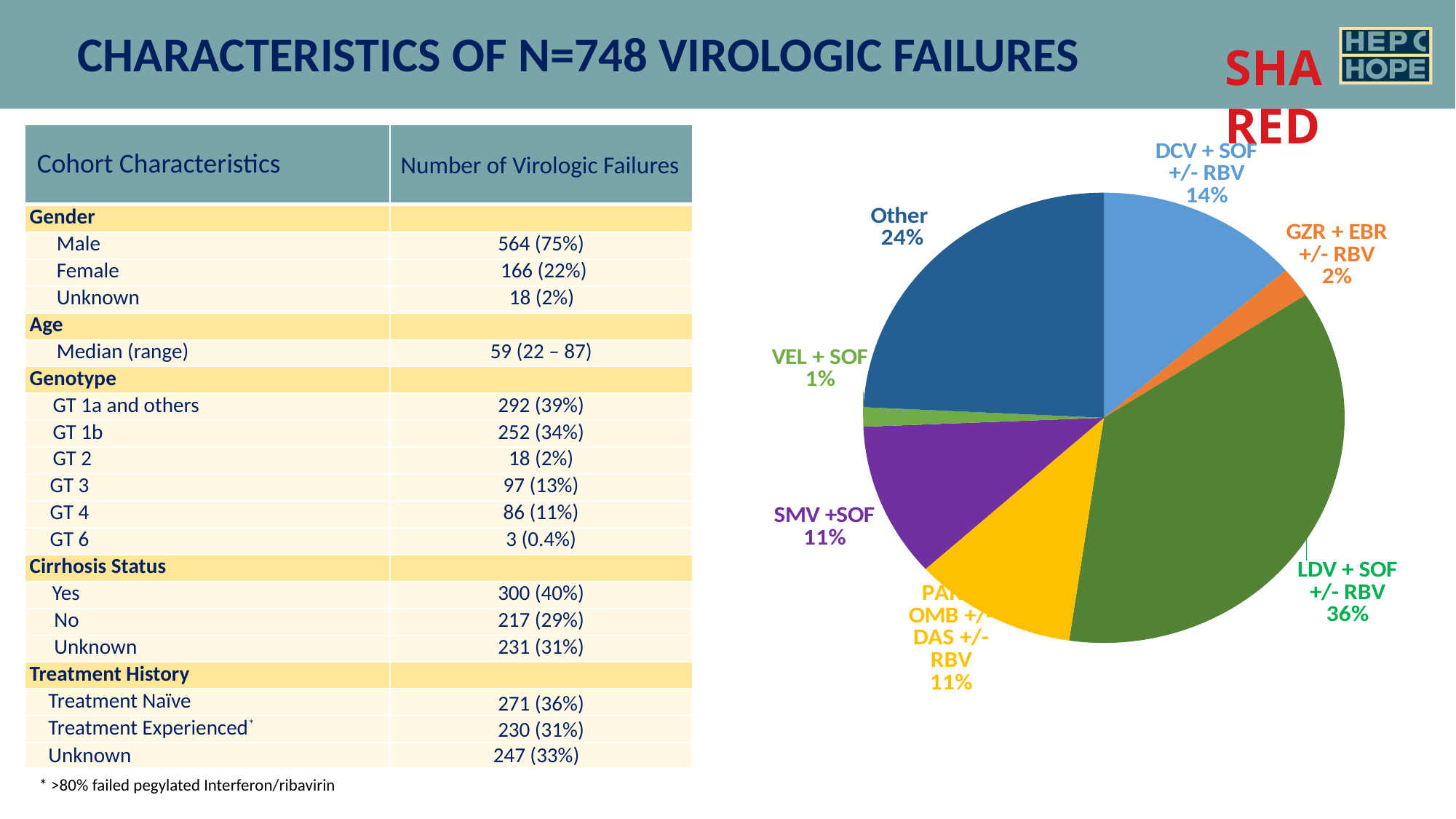
In the pie chart, what percentage is shown for DCV + SOF +/- RBV? 14% Which regimen has the largest slice in the pie chart? LDV + SOF +/- RBV In the pie chart, what percentage is shown for GZR + EBR +/- RBV? 2% In the pie chart, what percentage is shown for the Other category? 24% Which regimen has the smallest slice in the pie chart? VEL + SOF In the pie chart, what is the difference in percentage points between Other and DCV + SOF +/- RBV? 10 How many slices does the pie chart have? 7 What colour is the LDV + SOF +/- RBV slice in the pie chart? green In the pie chart, which is larger: the share for Other or the share for SMV +SOF? Other In the pie chart, what share of virologic failures is attributed to LDV + SOF +/- RBV? 36% In the pie chart, what percentage is shown for SMV +SOF? 11% What kind of chart is shown on the right side of the slide? pie chart